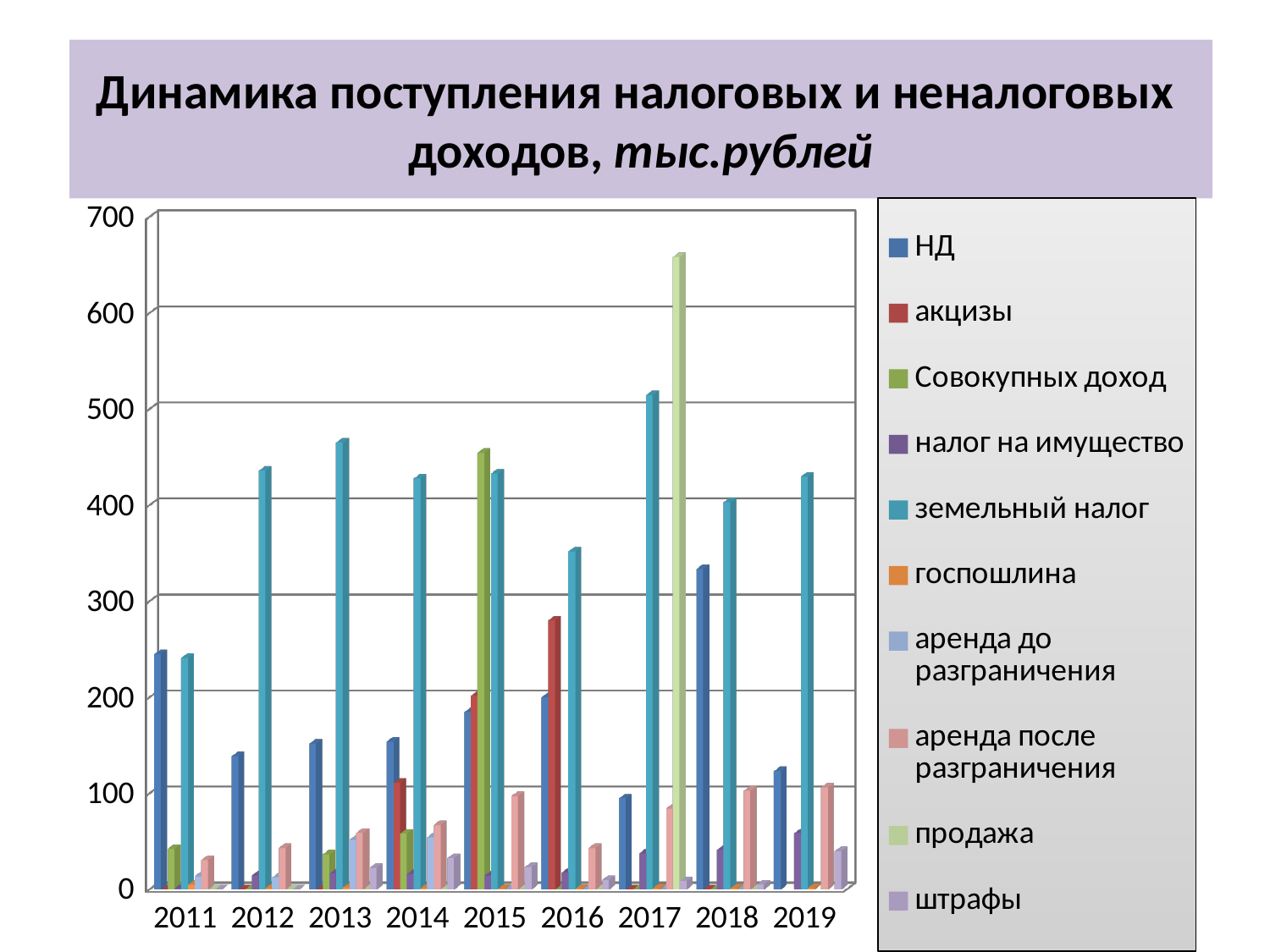
What kind of chart is shown on the slide? bar chart Is the value for земельный налог in 2016 greater or less than 400? less In which year does the series продажа reach its highest value? 2017 How many series does the legend list? 10 Is the value for продажа in 2017 greater or less than 600? greater In which year is the value for НД the highest? 2018 In which year is the value for земельный налог the highest? 2017 Is the value for земельный налог in 2013 greater or less than 400? greater How many years are shown on the x axis? 9 Which is larger: земельный налог in 2017 or земельный налог in 2016? земельный налог in 2017 What is the title of the chart? Динамика поступления налоговых и неналоговых доходов, тыс.рублей